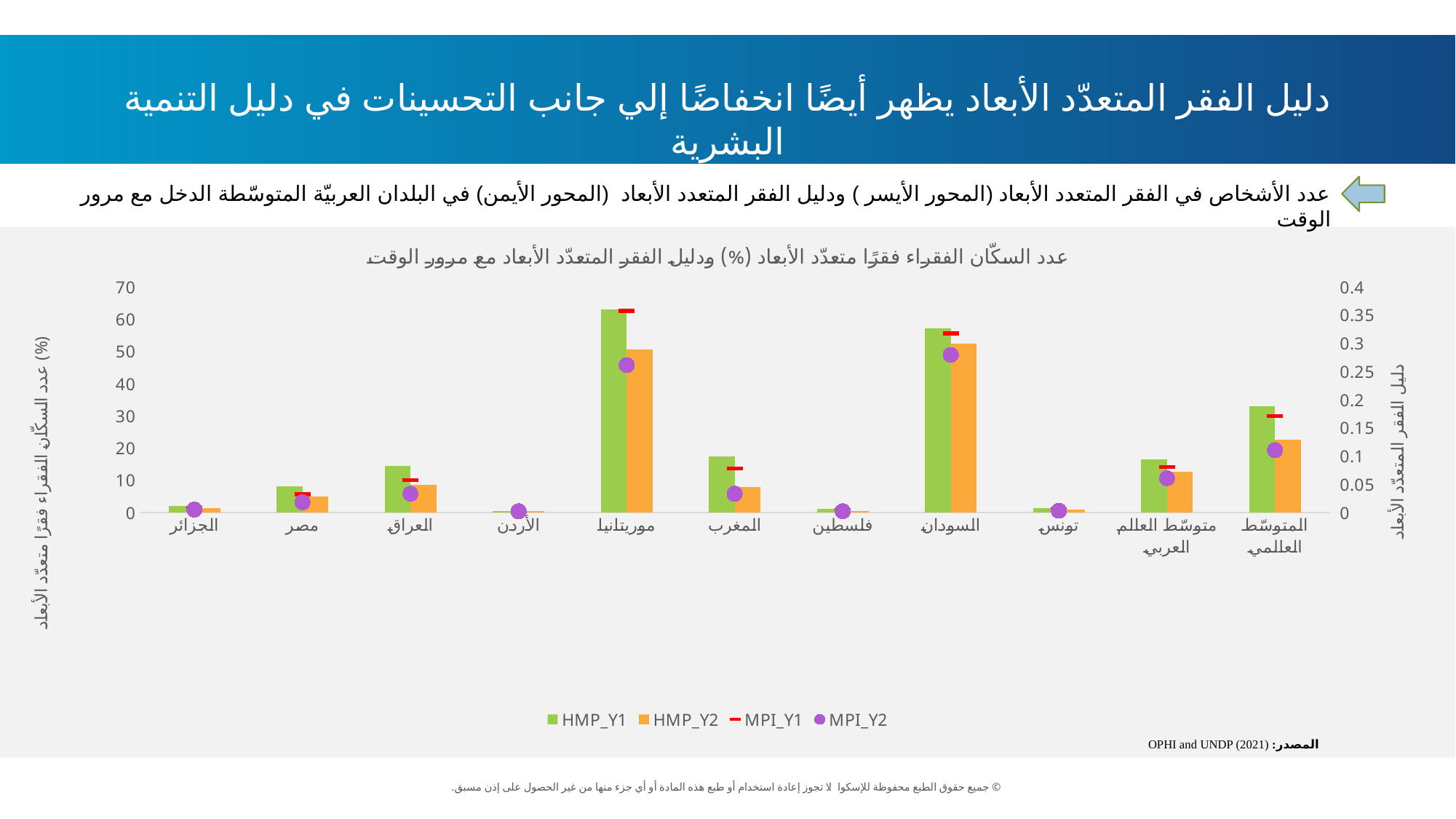
Is the HMP_Y1 value for السودان greater or less than 50? greater Is the HMP_Y1 value for مصر greater or less than 10? less Which category has the highest HMP_Y1 value? موريتانيا Is the HMP_Y1 value for المغرب greater or less than 20? less Which is larger, the HMP_Y1 value for موريتانيا or the HMP_Y1 value for السودان? موريتانيا Which series is shown in orange in the legend? HMP_Y2 What kind of chart is shown on the slide? combination chart of bars and markers (bar and line chart) How many categories are shown on the x axis of the chart? 11 How many series does the chart legend list? 4 For موريتانيا, which is larger, HMP_Y1 or HMP_Y2? HMP_Y1